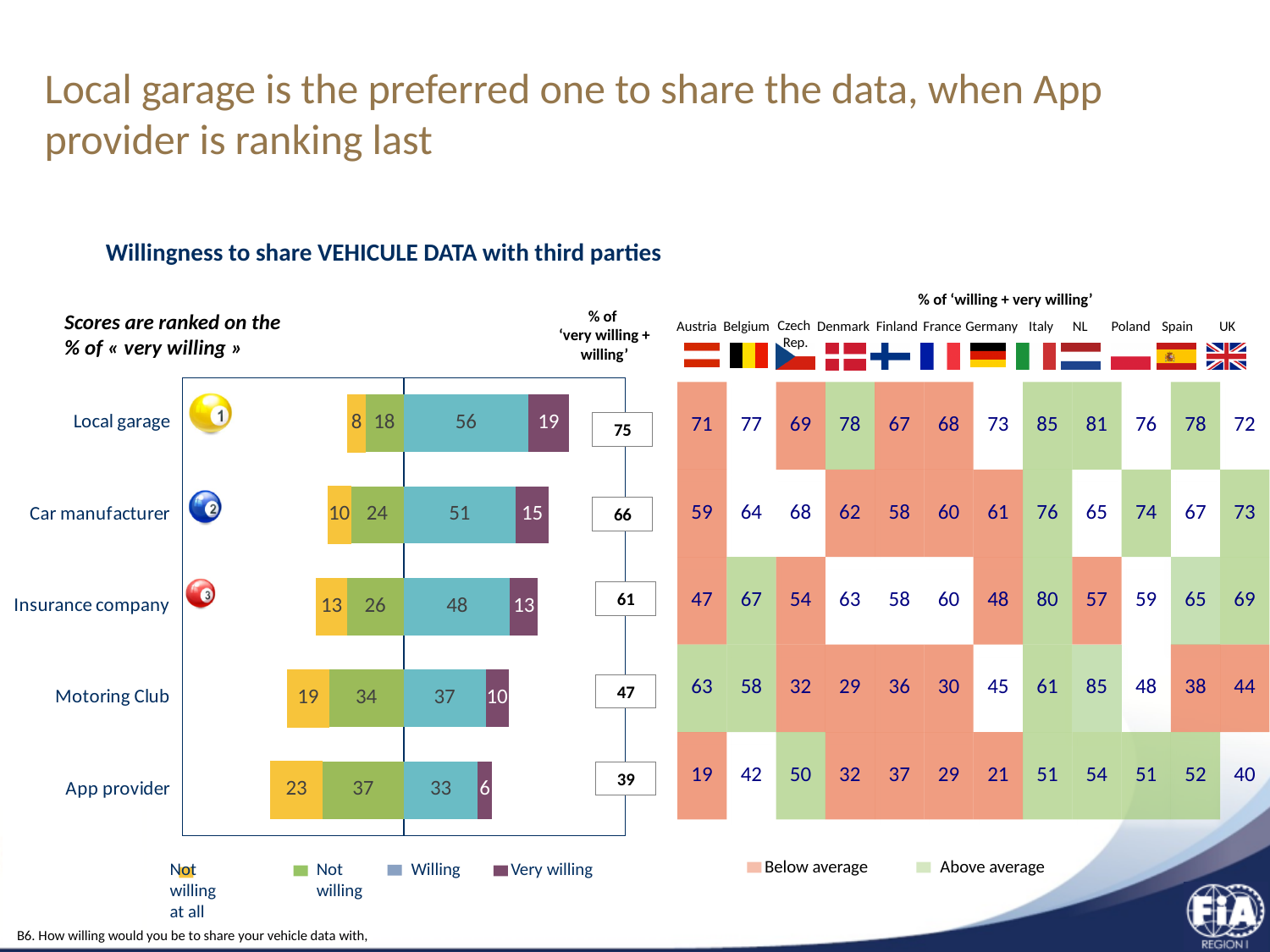
Which third party has the highest 'Very willing' value in the stacked bar chart? Local garage What is the '% of willing + very willing' value for Insurance company? 61 How many third parties (categories) are shown in the stacked bar chart? 5 Which is larger: the 'Willing' value for Insurance company or for Motoring Club? Insurance company In the stacked bar chart, what is the 'Very willing' value for Local garage? 19 What kind of chart is used to show willingness to share vehicle data with third parties? stacked bar chart In the stacked bar chart, what is the 'Willing' value for Car manufacturer? 51 How many series does the legend of the stacked bar chart list? 4 Which third party has the lowest '% of willing + very willing' value? App provider In the country table, what is the '% of willing + very willing' value for Italy for Local garage? 85 In the stacked bar chart, what is the 'Not willing at all' value for App provider? 23 What is the difference between the 'Not willing' values for Motoring Club and Local garage? 16